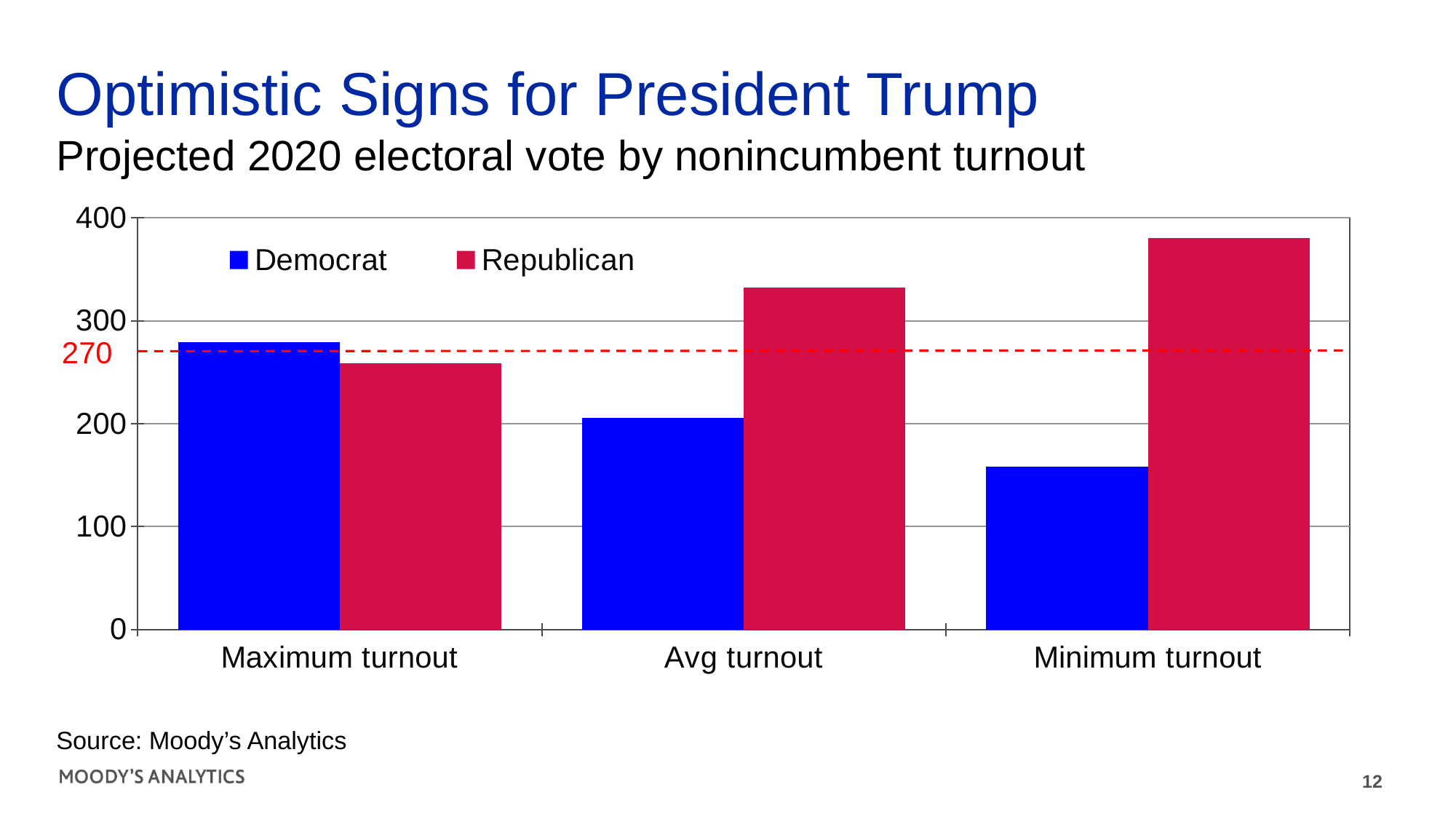
For Avg turnout, which series has the larger value, Democrat or Republican? Republican What value is marked by the red dashed horizontal line? 270 How many turnout categories are shown on the x axis? 3 Which turnout category has the lowest Democrat value? Minimum turnout Is the Republican value for Maximum turnout greater or less than 270? less Is the Democrat value for Maximum turnout greater or less than 300? less How many series does the legend list? 2 Which turnout category has the highest Republican value? Minimum turnout Is the Democrat value for Minimum turnout greater or less than 200? less Do the Republican values rise or fall moving from Maximum turnout to Minimum turnout? rise What kind of chart is shown on the slide? bar chart